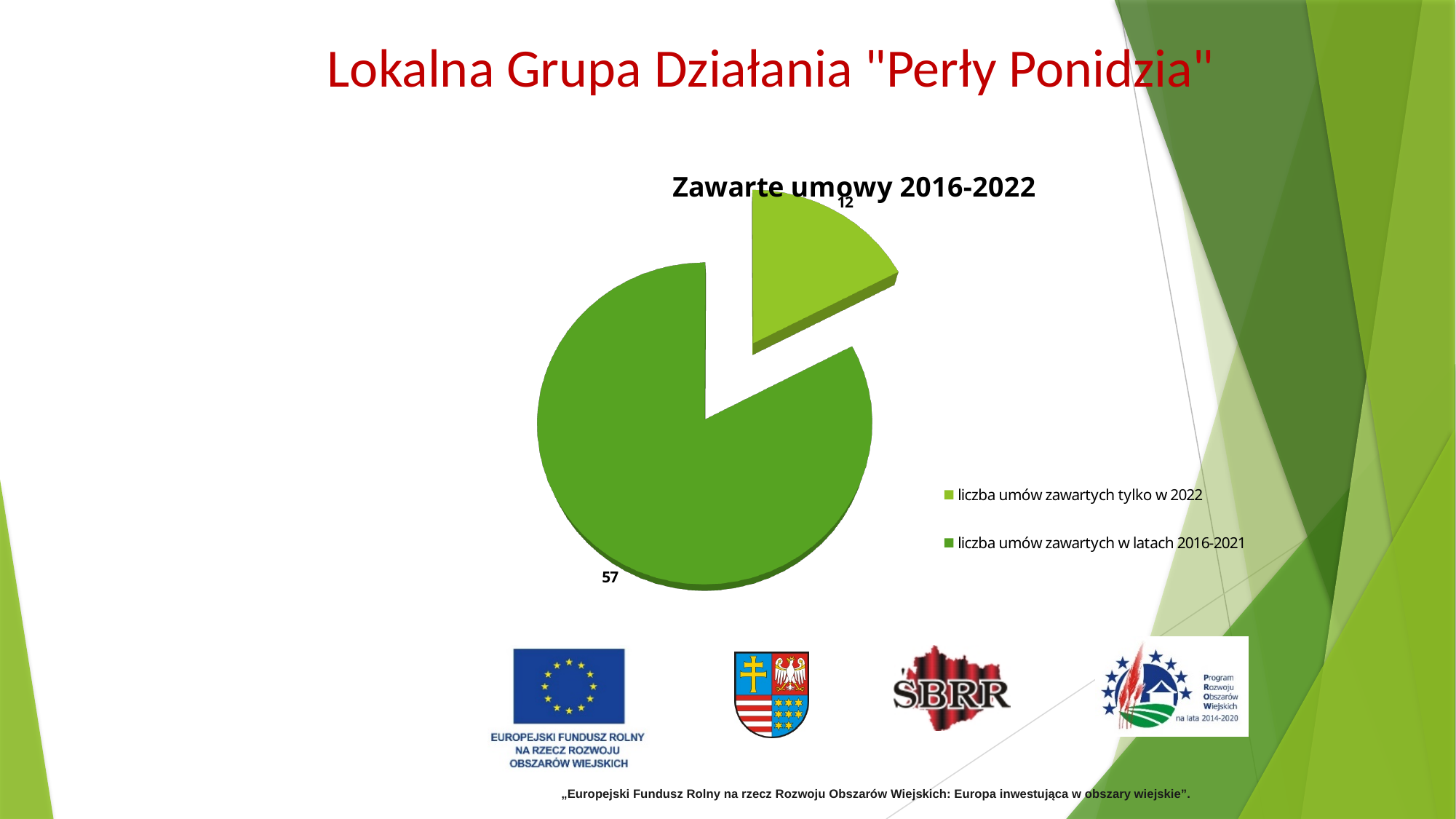
Which category has the largest slice of the pie? liczba umów zawartych w latach 2016-2021 How many entries does the legend list? 2 What is the value for "liczba umów zawartych tylko w 2022"? 12 What is the difference between the number of contracts concluded in 2016-2021 and those concluded only in 2022? 45 What is the title of the chart? Zawarte umowy 2016-2022 Which colour represents "liczba umów zawartych tylko w 2022" in the pie chart? light green Which is larger: the value for "liczba umów zawartych tylko w 2022" or the value for "liczba umów zawartych w latach 2016-2021"? liczba umów zawartych w latach 2016-2021 What is the value for "liczba umów zawartych w latach 2016-2021"? 57 What type of chart is shown on the slide? pie chart Which category has the smallest slice of the pie? liczba umów zawartych tylko w 2022 How many slices does the pie chart have? 2 What is the total of the two slices in the pie chart? 69